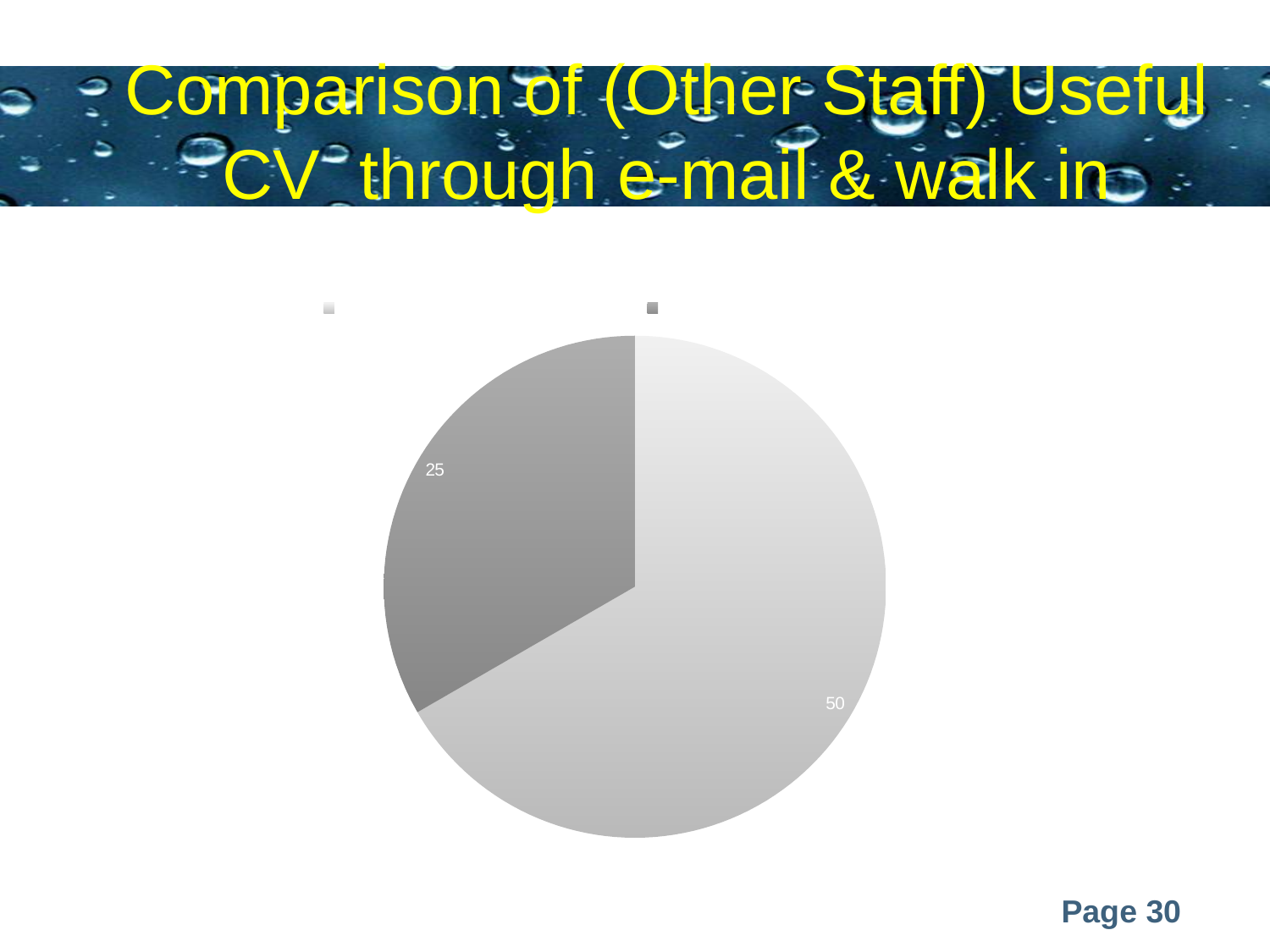
What value is printed on the smaller, dark grey slice of the pie chart? 25 What share of the whole pie does the slice labelled 25 represent? one third What kind of chart is shown on the slide? pie chart How many slices does the pie chart have? 2 Is the value on the light grey slice larger or smaller than the value on the dark grey slice? larger What is the total of the two values printed on the pie chart? 75 What is the difference between the two values printed on the pie chart? 25 What value is printed on the larger, light grey slice of the pie chart? 50 How many entries does the legend above the pie chart show? 2 Which slice of the pie chart is the smallest, the light grey one or the dark grey one? the dark grey one Which slice of the pie chart is the largest, the light grey one or the dark grey one? the light grey one What is the title of the slide containing the pie chart? Comparison of (Other Staff) Useful CV through e-mail & walk in